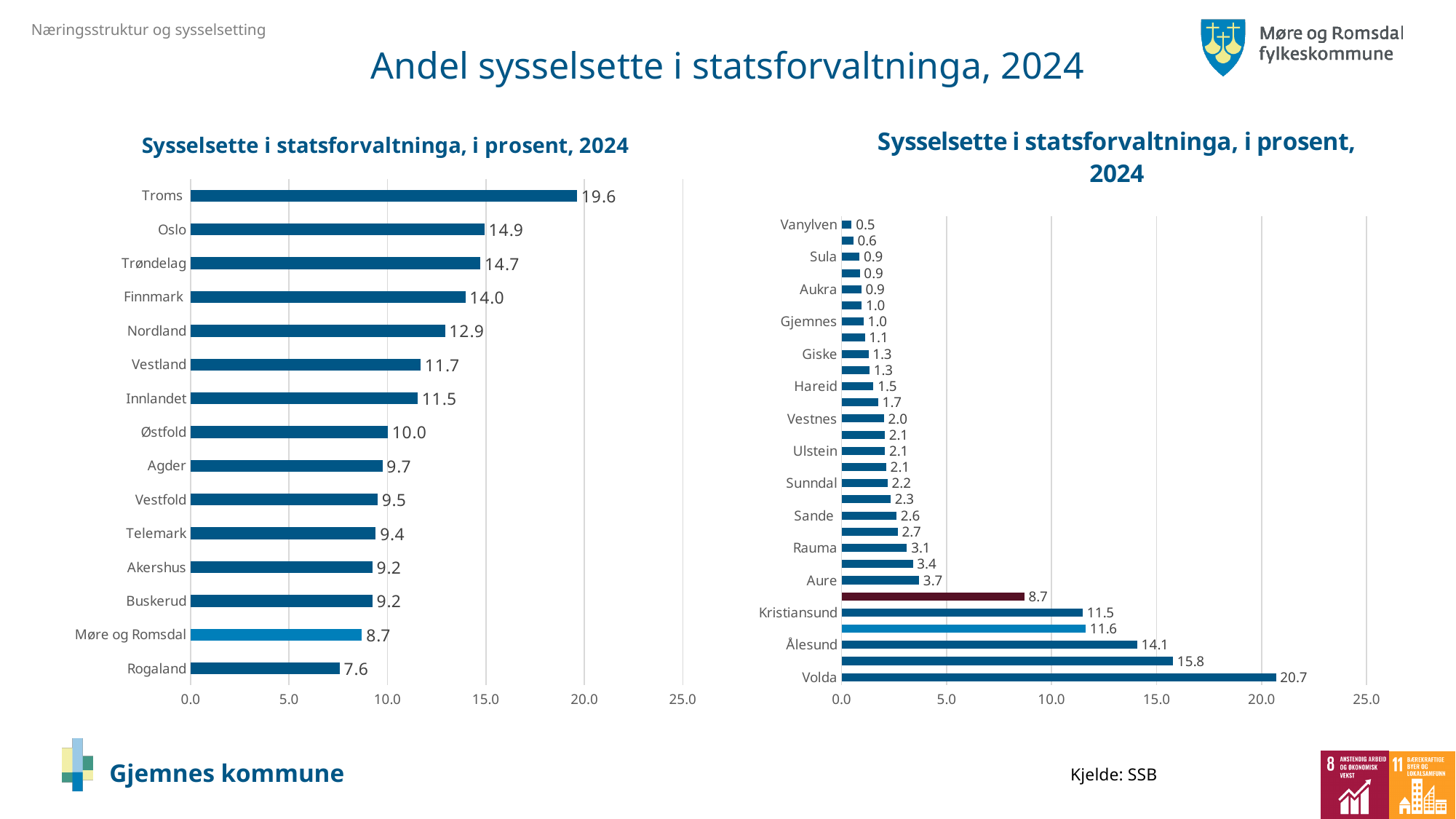
On the right chart, is the value for Aure greater or less than 5.0? less On the right chart, what is the value for Volda? 20.7 What kind of chart is the left chart? Bar chart On the left chart, which category has the lowest value? Rogaland On the left chart, what is the value for Møre og Romsdal? 8.7 On the right chart, which category has the highest value? Volda How many categories are shown on the left chart? 15 On the right chart, what is the value for Gjemnes? 1.0 On the left chart, what is the value for Troms? 19.6 On the left chart, which is larger, the value for Nordland or the value for Vestland? Nordland On the left chart, what is the difference between the values for Oslo and Finnmark? 0.9 On the right chart, what is the difference between the values for Ålesund and Kristiansund? 2.6